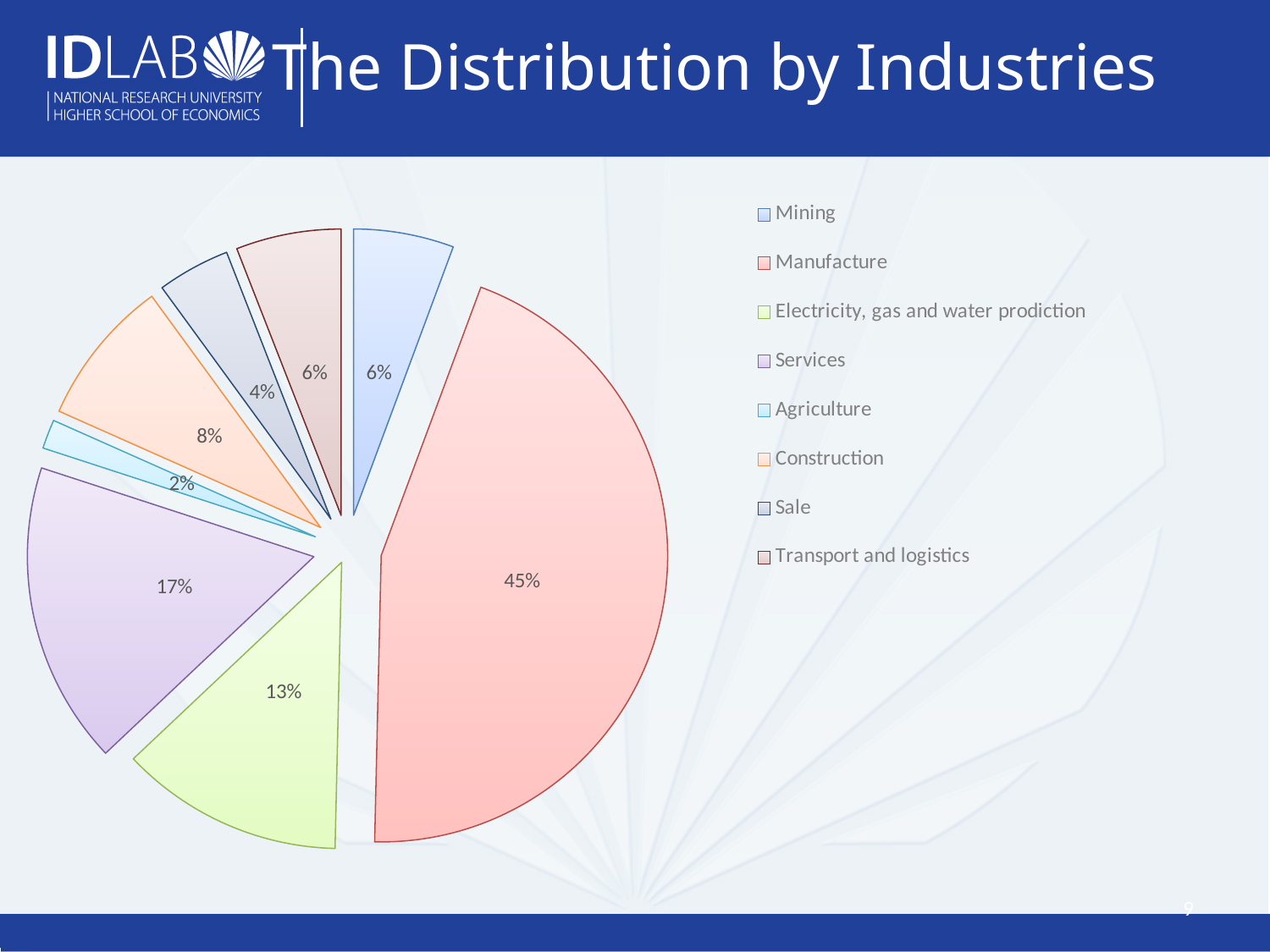
Which industry has the largest share of the pie? Manufacture What kind of chart is shown on the slide? pie chart What is the value for Agriculture? 2% Which industry has the smallest share of the pie? Agriculture What is the difference between the shares of Services and Electricity, gas and water prodiction? 4% What is the value for Construction? 8% What share of the pie does Manufacture have? 45% What is the title of the slide containing the chart? The Distribution by Industries What is the value for Services? 17% What is the value for Electricity, gas and water prodiction? 13% How many industries are listed in the legend? 8 Which is larger, the share for Construction or the share for Sale? Construction